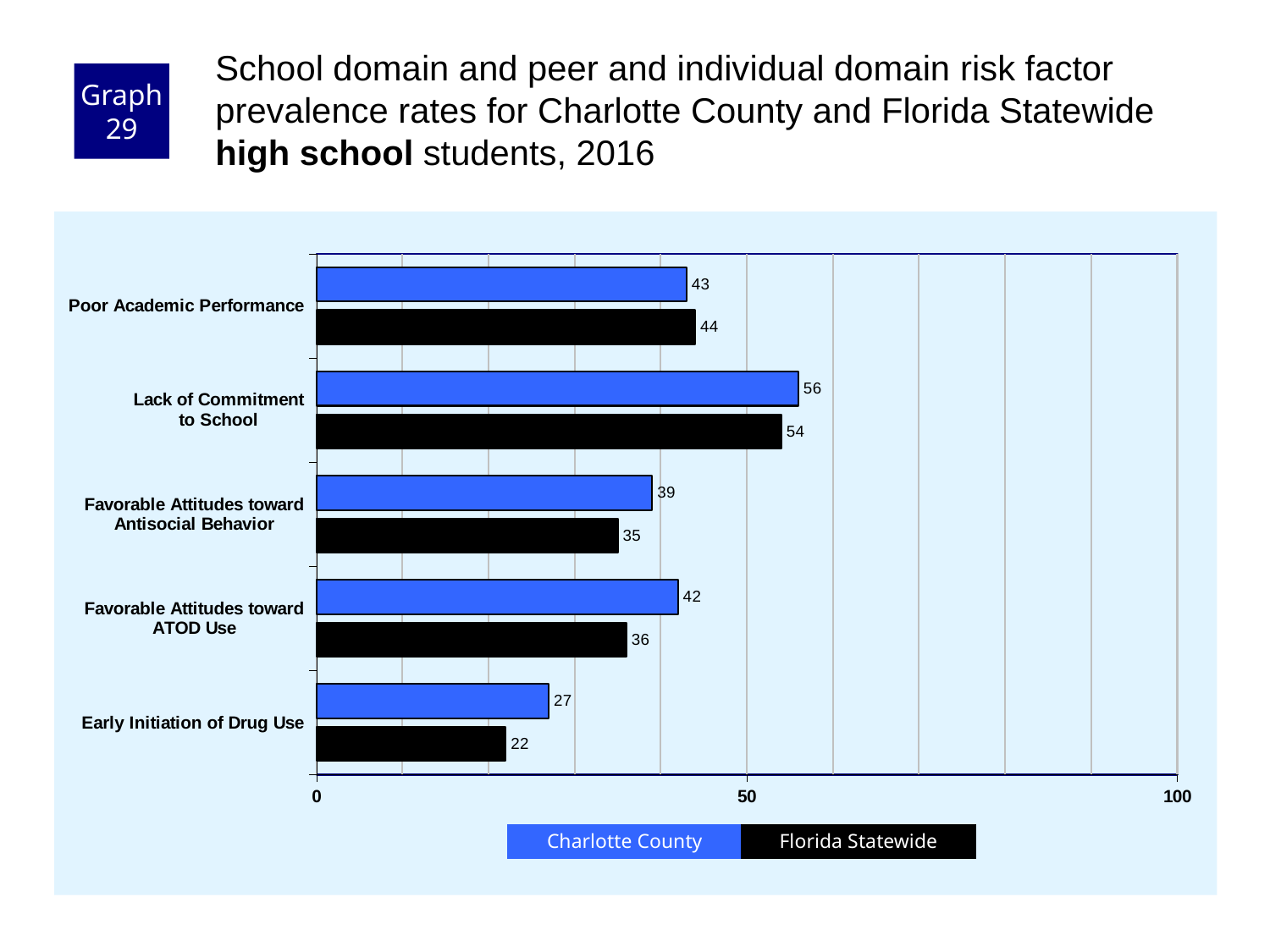
Which is larger for Poor Academic Performance: the Charlotte County value or the Florida Statewide value? Florida Statewide What is the Florida Statewide value for Early Initiation of Drug Use? 22 Which risk factor has the highest Charlotte County value? Lack of Commitment to School What is the Charlotte County value for Lack of Commitment to School? 56 Which colour represents Florida Statewide in the chart? black What is the difference between the Charlotte County and Florida Statewide values for Favorable Attitudes toward ATOD Use? 6 Is the Charlotte County value for Lack of Commitment to School greater or less than 50? greater How many risk factors are shown on the chart? 5 Which risk factor has the lowest Florida Statewide value? Early Initiation of Drug Use What is the Florida Statewide value for Favorable Attitudes toward ATOD Use? 36 What kind of chart is shown on the slide? bar chart How many series does the legend list? 2